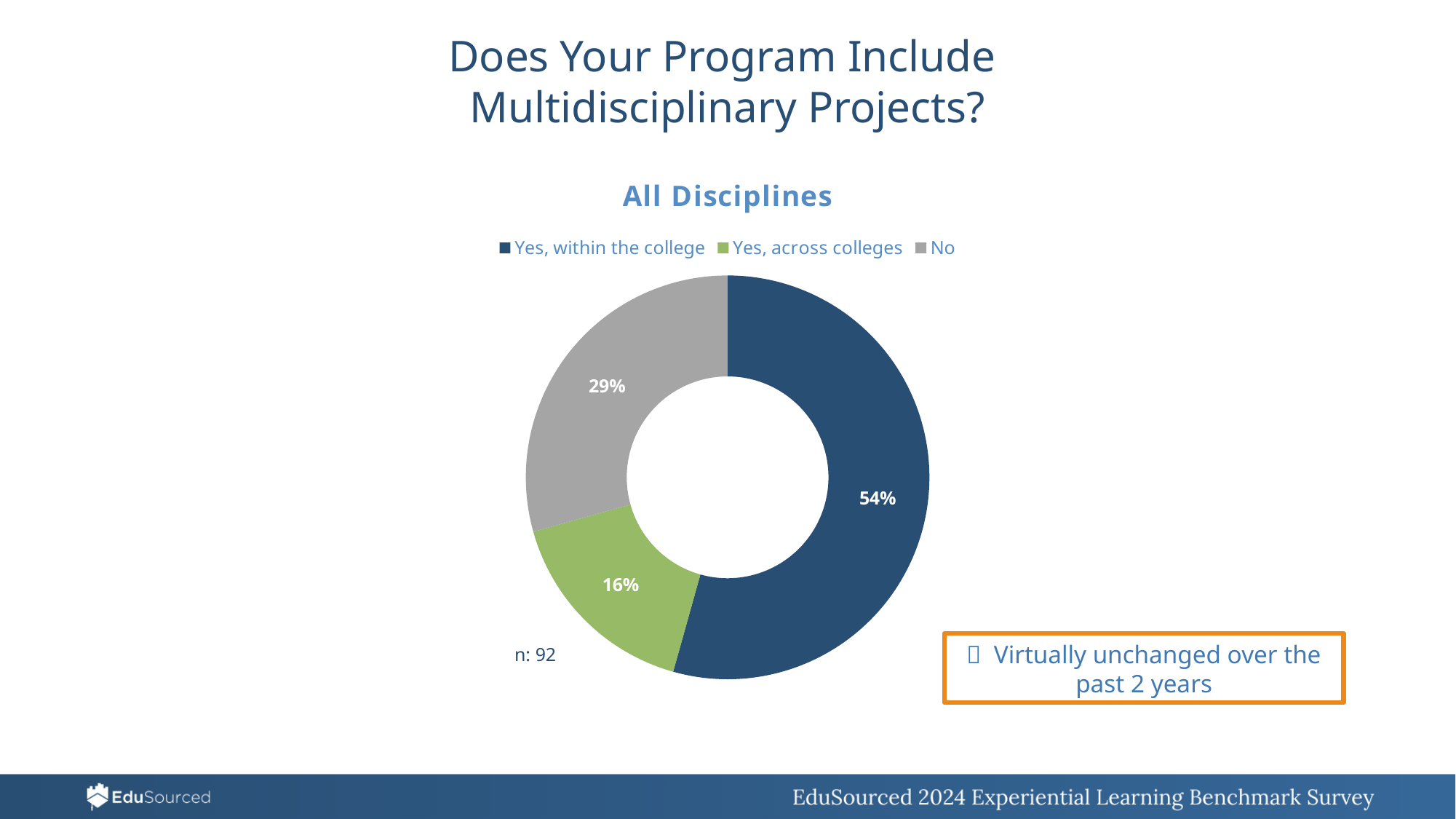
Which response has the smallest share of the chart? Yes, across colleges What percentage of respondents answered "Yes, across colleges"? 16% What colour represents the "No" response in the chart? Gray Which is larger: the share for "No" or the share for "Yes, across colleges"? No What is the difference in percentage points between "Yes, within the college" and "No"? 25 What percentage of respondents answered "Yes, within the college"? 54% What is the combined share of the two "Yes" responses? 70% What percentage of respondents answered "No"? 29% How many response categories are shown in the chart? 3 What kind of chart is shown on the slide? Pie chart (donut) What is the sample size (n) shown for the chart? 92 Which response has the largest share of the chart? Yes, within the college